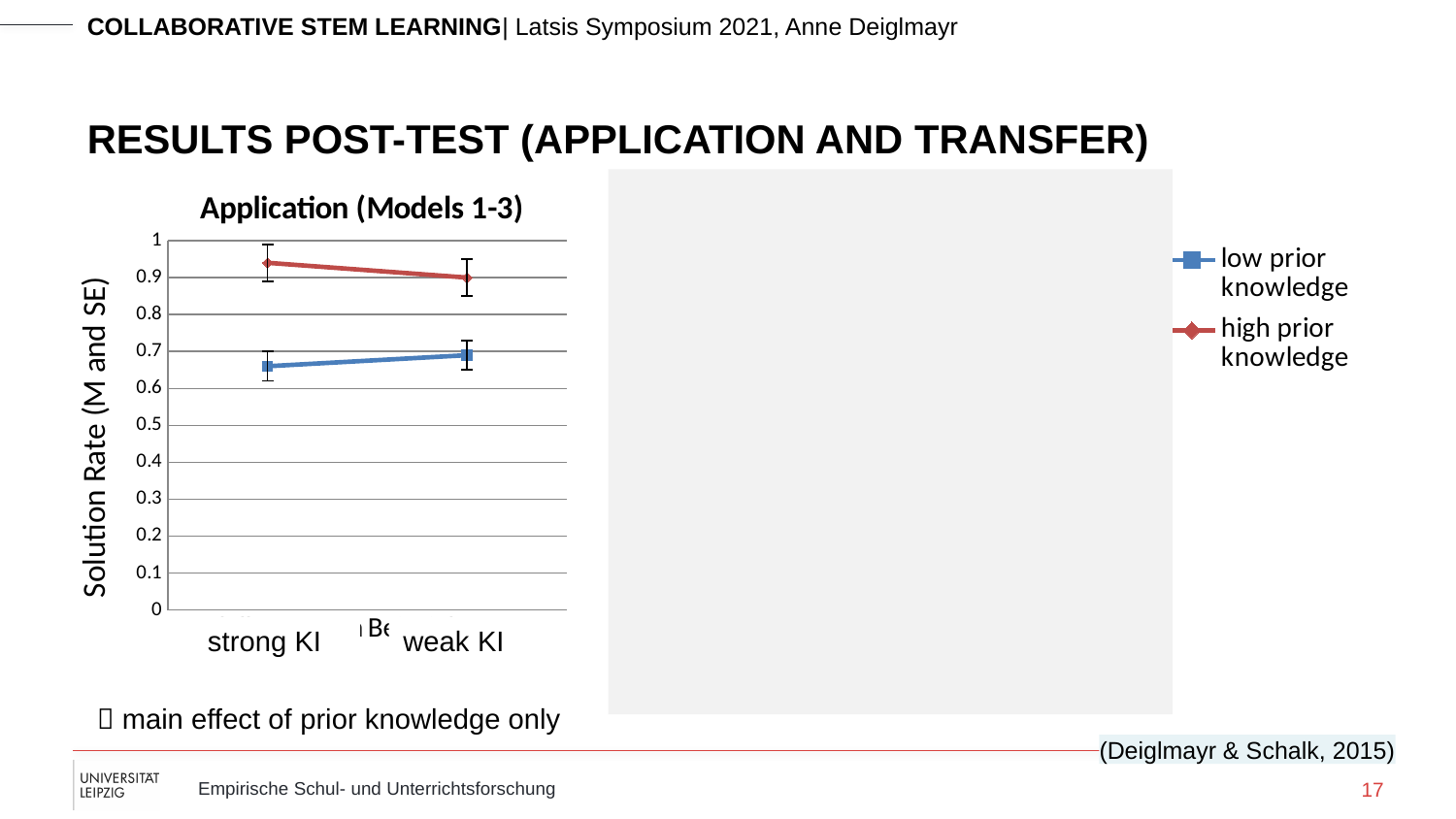
Is the value for low prior knowledge at weak KI greater or less than 0.6? greater Does the low prior knowledge line rise or fall from strong KI to weak KI? rise Does the high prior knowledge line rise or fall from strong KI to weak KI? fall How many series does the legend list? 2 Which series has the higher value at strong KI, low prior knowledge or high prior knowledge? high prior knowledge Is the value for high prior knowledge at strong KI greater or less than 0.9? greater What is the label of the y axis? Solution Rate (M and SE) How many categories are shown on the x axis? 2 What is the title of the chart? Application (Models 1-3) Is the value for high prior knowledge at weak KI greater or less than 0.8? greater What kind of chart is shown on the slide? line chart